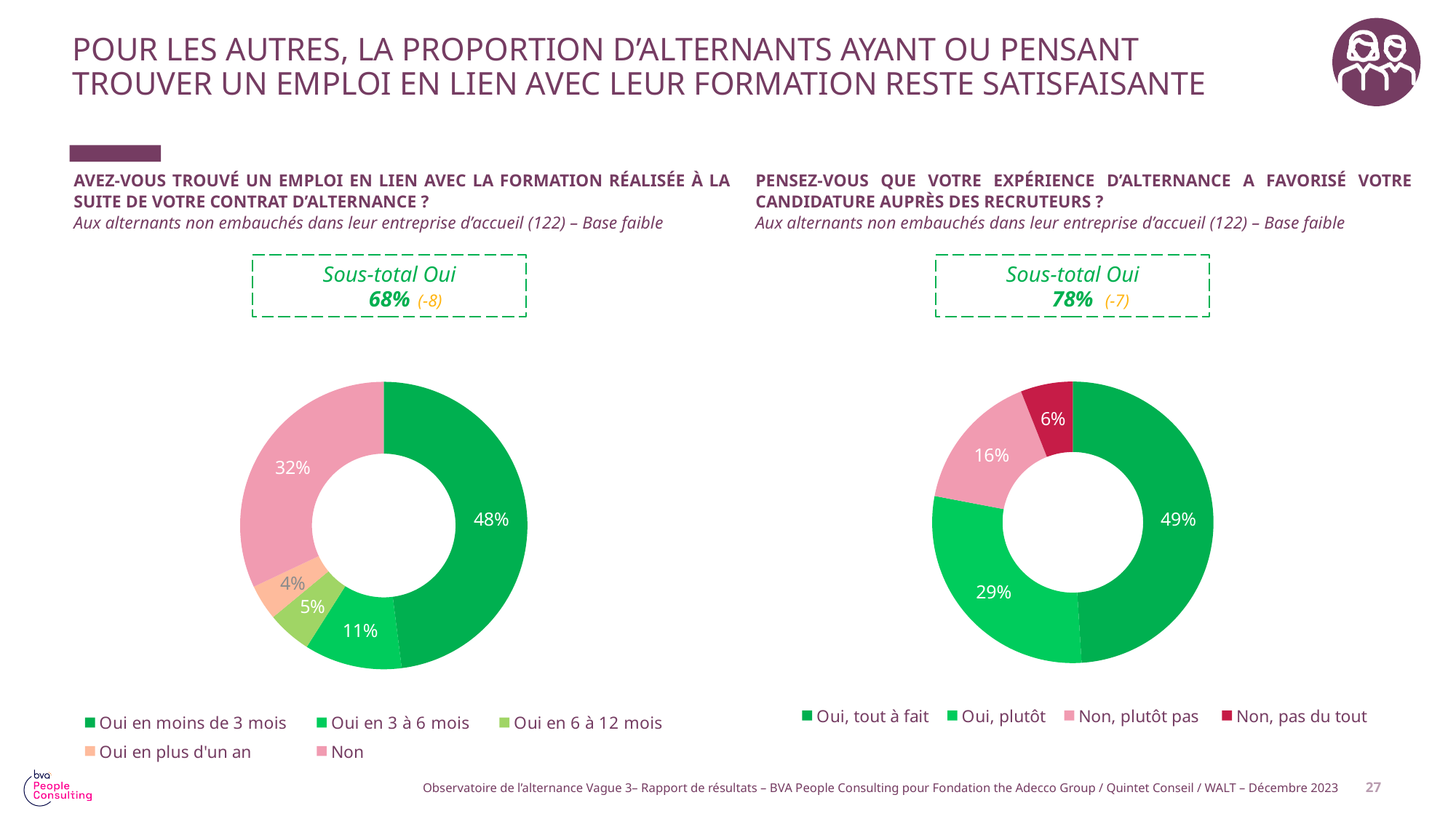
In the right chart, what share of respondents answered "Non, pas du tout"? 6% In the right chart, which category has the largest share? Oui, tout à fait In the left chart, which category has the smallest share? Oui en plus d'un an In the right chart, what is the combined share of "Oui, tout à fait" and "Oui, plutôt"? 78% In the left chart, what share of respondents answered "Non"? 32% In the left chart, what is the difference between the "Oui en moins de 3 mois" share and the "Non" share? 16 percentage points In the left chart, what share of respondents answered "Oui en moins de 3 mois"? 48% In the right chart, what share of respondents answered "Oui, plutôt"? 29% In the left chart, how many categories does the legend list? 5 In the right chart, which is larger: the share for "Non, plutôt pas" or the share for "Non, pas du tout"? Non, plutôt pas What is the "Sous-total Oui" value shown above the left chart? 68% What type of chart is used on the left side of the slide? Donut (pie) chart